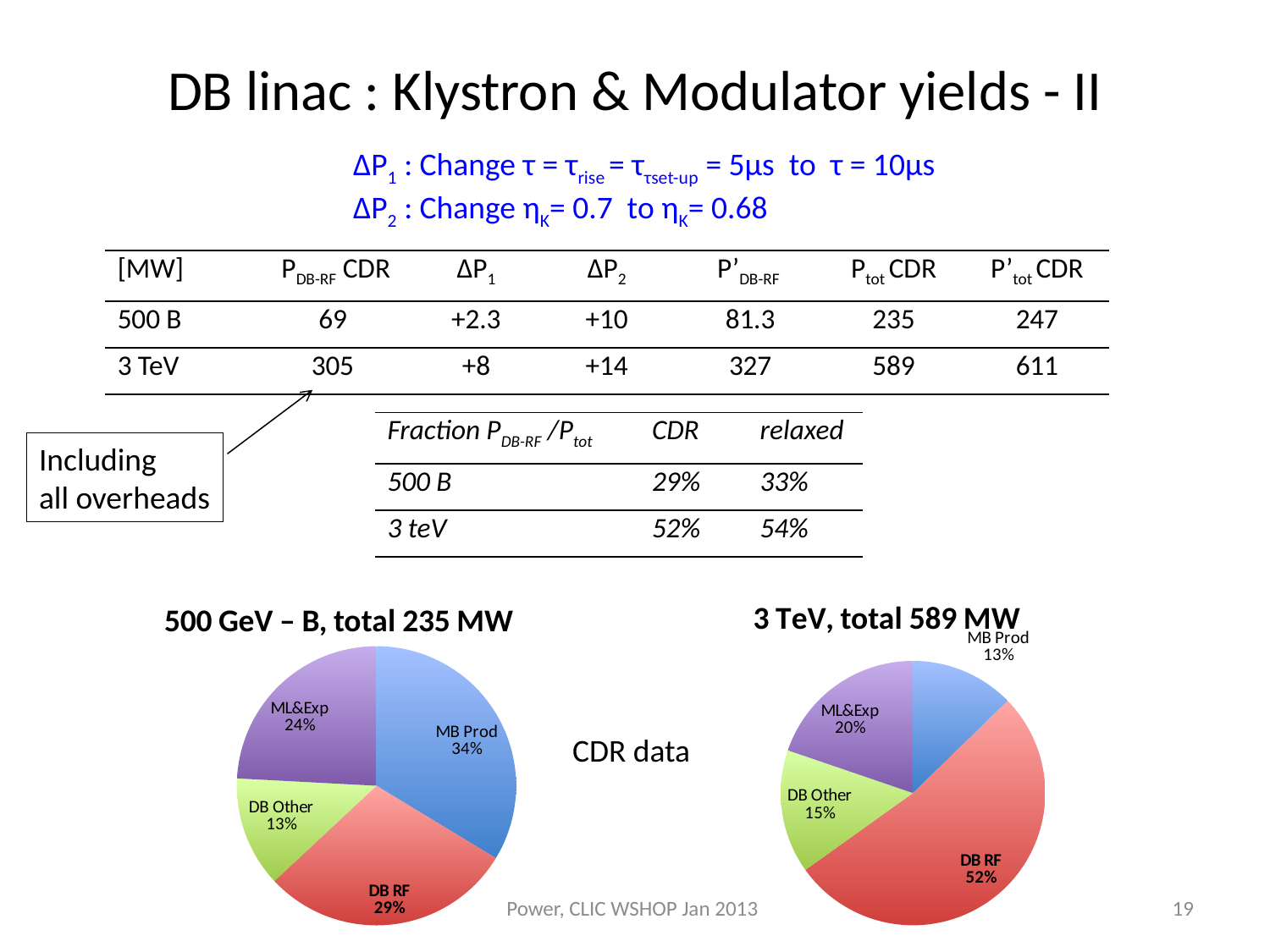
In the '3 TeV, total 589 MW' chart, what share does DB RF have? 52% In the '500 GeV – B, total 235 MW' chart, which slice is the largest? MB Prod What kind of chart is the '500 GeV – B, total 235 MW' chart? Pie chart In the '500 GeV – B, total 235 MW' chart, what share does MB Prod have? 34% In the '3 TeV, total 589 MW' chart, what share does ML&Exp have? 20% In the '500 GeV – B, total 235 MW' chart, which is larger, ML&Exp or DB RF? DB RF In the '500 GeV – B, total 235 MW' chart, which slice is the smallest? DB Other How many slices does the '3 TeV, total 589 MW' chart have? 4 In the '500 GeV – B, total 235 MW' chart, what share does DB RF have? 29% In the '3 TeV, total 589 MW' chart, what is the difference between the DB RF share and the DB Other share? 37% In the '3 TeV, total 589 MW' chart, which slice is the largest? DB RF In the '3 TeV, total 589 MW' chart, which slice is the smallest? MB Prod